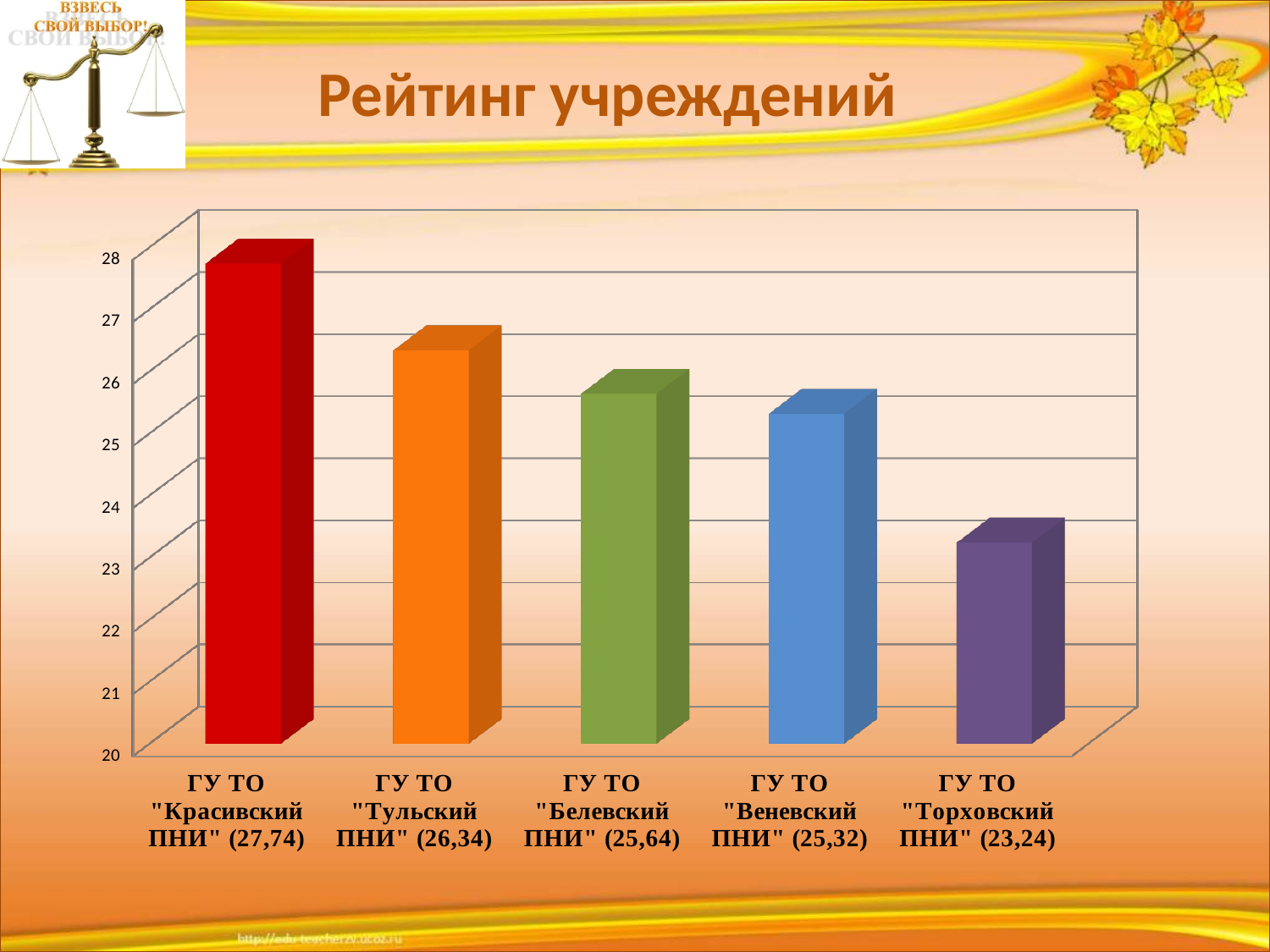
Do the values rise or fall from left to right along the x axis? fall Is the value for ГУ ТО "Веневский ПНИ" greater or less than 26? less What is the difference between the ratings of ГУ ТО "Тульский ПНИ" and ГУ ТО "Белевский ПНИ"? 0,70 What is the difference between the ratings of ГУ ТО "Красивский ПНИ" and ГУ ТО "Торховский ПНИ"? 4,50 What value is shown for ГУ ТО "Белевский ПНИ"? 25,64 Which institution has the lowest rating on the chart? ГУ ТО "Торховский ПНИ" How many institutions are shown on the chart? 5 Which has a higher rating, ГУ ТО "Тульский ПНИ" or ГУ ТО "Веневский ПНИ"? ГУ ТО "Тульский ПНИ" What kind of chart is shown on the slide? bar chart What value is shown for ГУ ТО "Красивский ПНИ"? 27,74 What value is shown for ГУ ТО "Торховский ПНИ"? 23,24 Which institution has the highest rating on the chart? ГУ ТО "Красивский ПНИ"